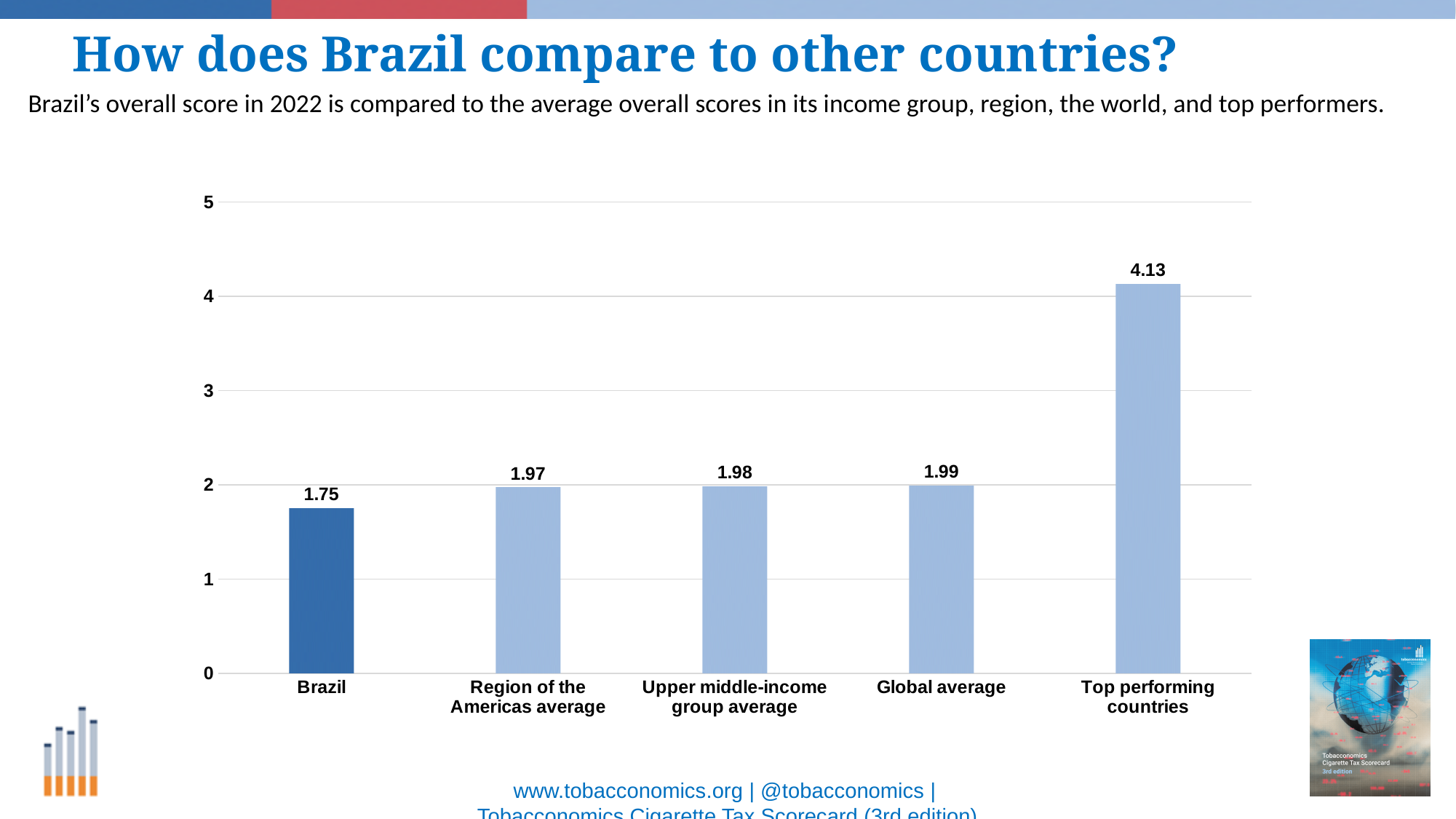
Which category has the lowest value? Brazil What kind of chart is shown on the slide? bar chart Which is larger, the value for Brazil or the value for Global average? Global average What is the value for Upper middle-income group average? 1.98 What is the value for Brazil? 1.75 What is the difference between the value for Top performing countries and the value for Brazil? 2.38 Is the value for Top performing countries greater or less than 4? greater What is the difference between the value for Region of the Americas average and the value for Brazil? 0.22 Which category has the highest value? Top performing countries What is the value for Global average? 1.99 What is the value for Top performing countries? 4.13 How many categories are shown on the chart? 5